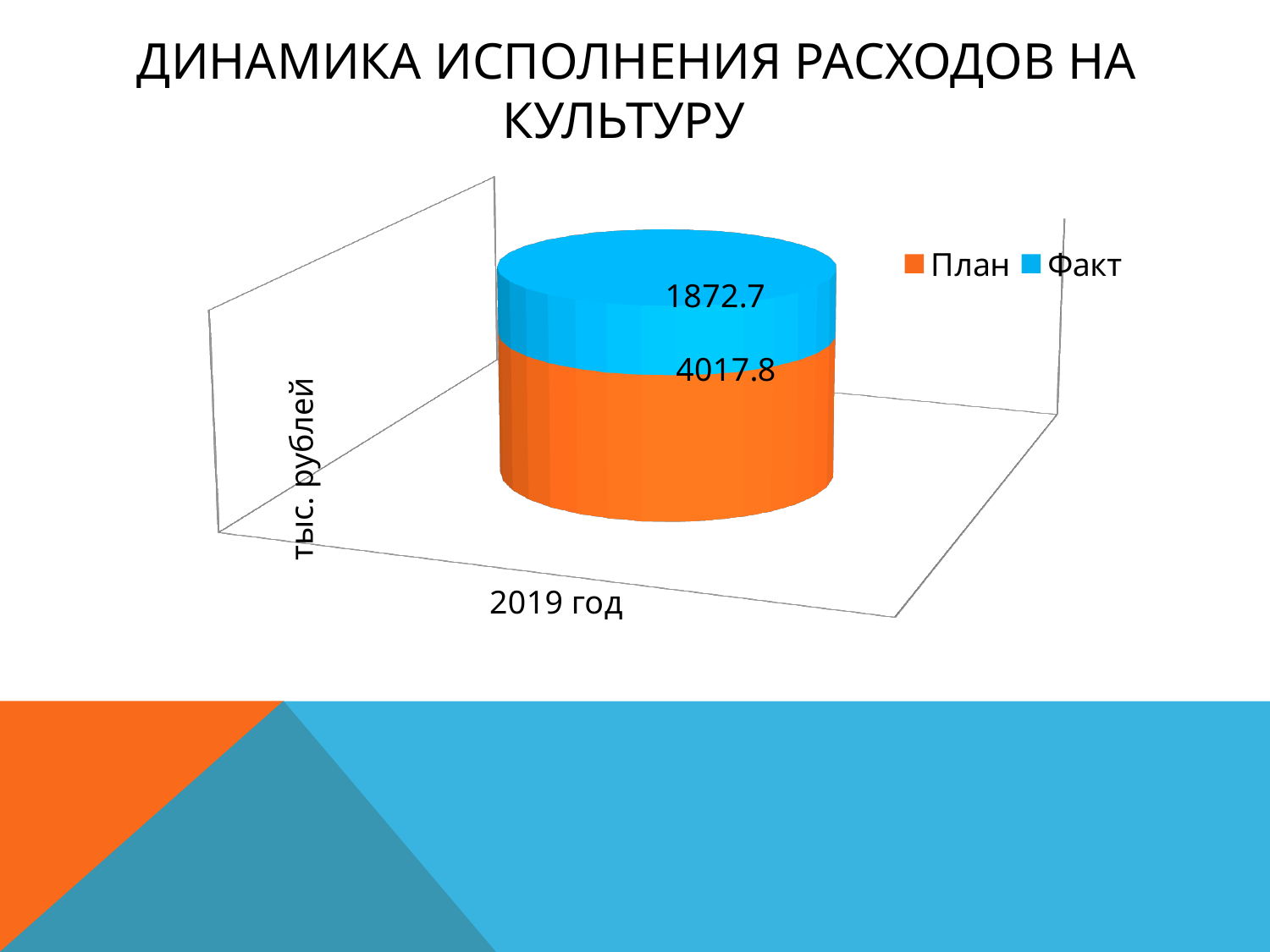
What kind of chart is shown on the slide? Stacked bar chart What is the value for План in 2019 год? 4017.8 How many categories are shown on the x axis? 1 What unit is given on the vertical axis label? тыс. рублей What is the title of the chart? ДИНАМИКА ИСПОЛНЕНИЯ РАСХОДОВ НА КУЛЬТУРУ Which series is the smaller segment of the stacked bar for 2019 год? Факт Which series has the larger value for 2019 год, План or Факт? План What is the total of the stacked bar for 2019 год? 5890.5 What is the value for Факт in 2019 год? 1872.7 What is the difference between the План and Факт values for 2019 год? 2145.1 How many series does the legend list? 2